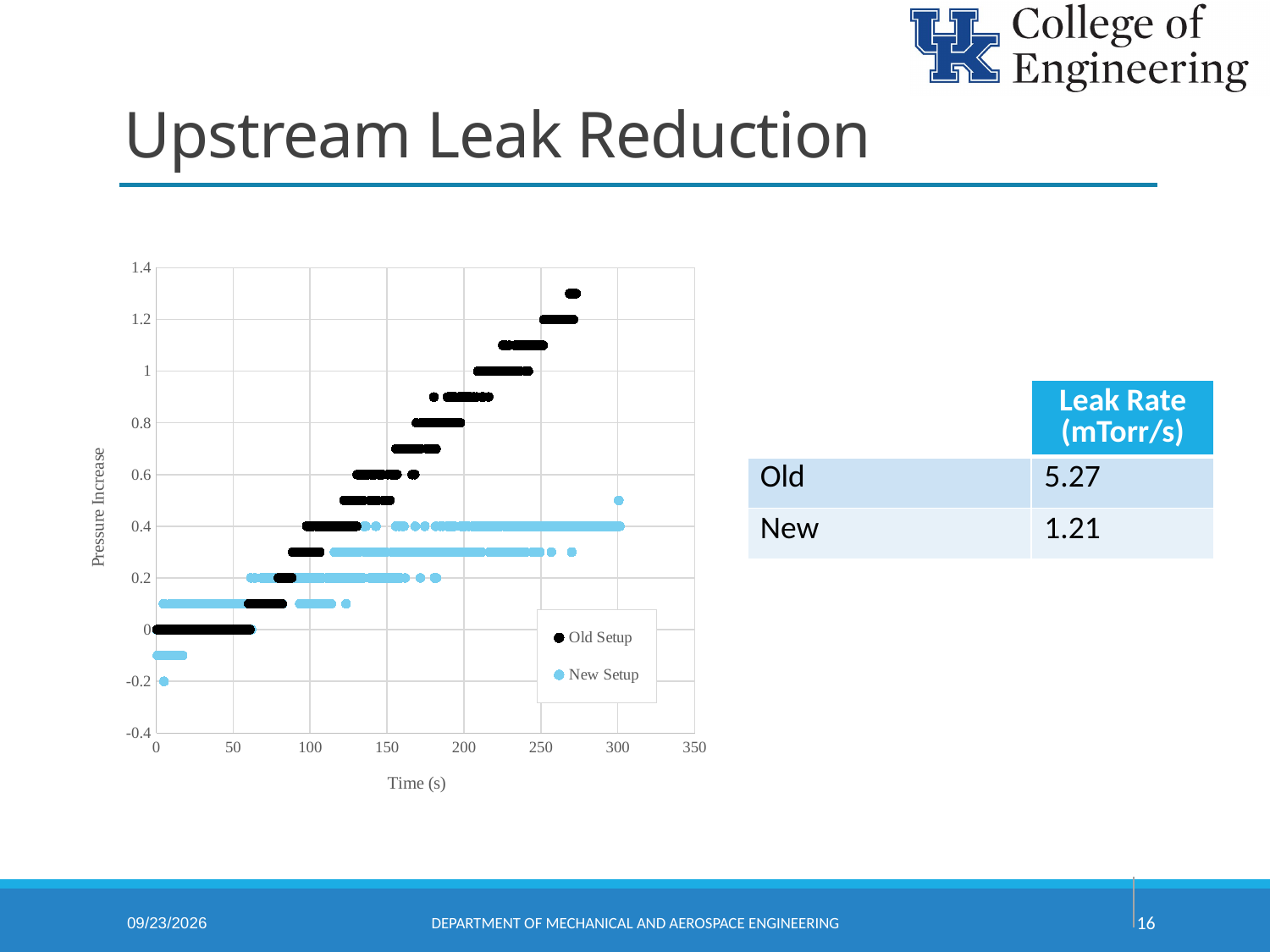
What are the two series named in the chart legend? Old Setup and New Setup Is the lowest pressure increase value of the New Setup series greater or less than 0? less Which series reaches the higher pressure increase, Old Setup or New Setup? Old Setup Is the highest pressure increase reached by the New Setup series greater or less than 0.6? less What is the title of the chart's x axis? Time (s) How many series does the chart legend list? 2 Is the pressure increase for the New Setup series at 200 s greater or less than 0.6? less Do the Old Setup pressure increase values rise or fall as time increases? rise What kind of chart is shown on the slide? scatter chart At around 250 s, which series shows the higher pressure increase, Old Setup or New Setup? Old Setup